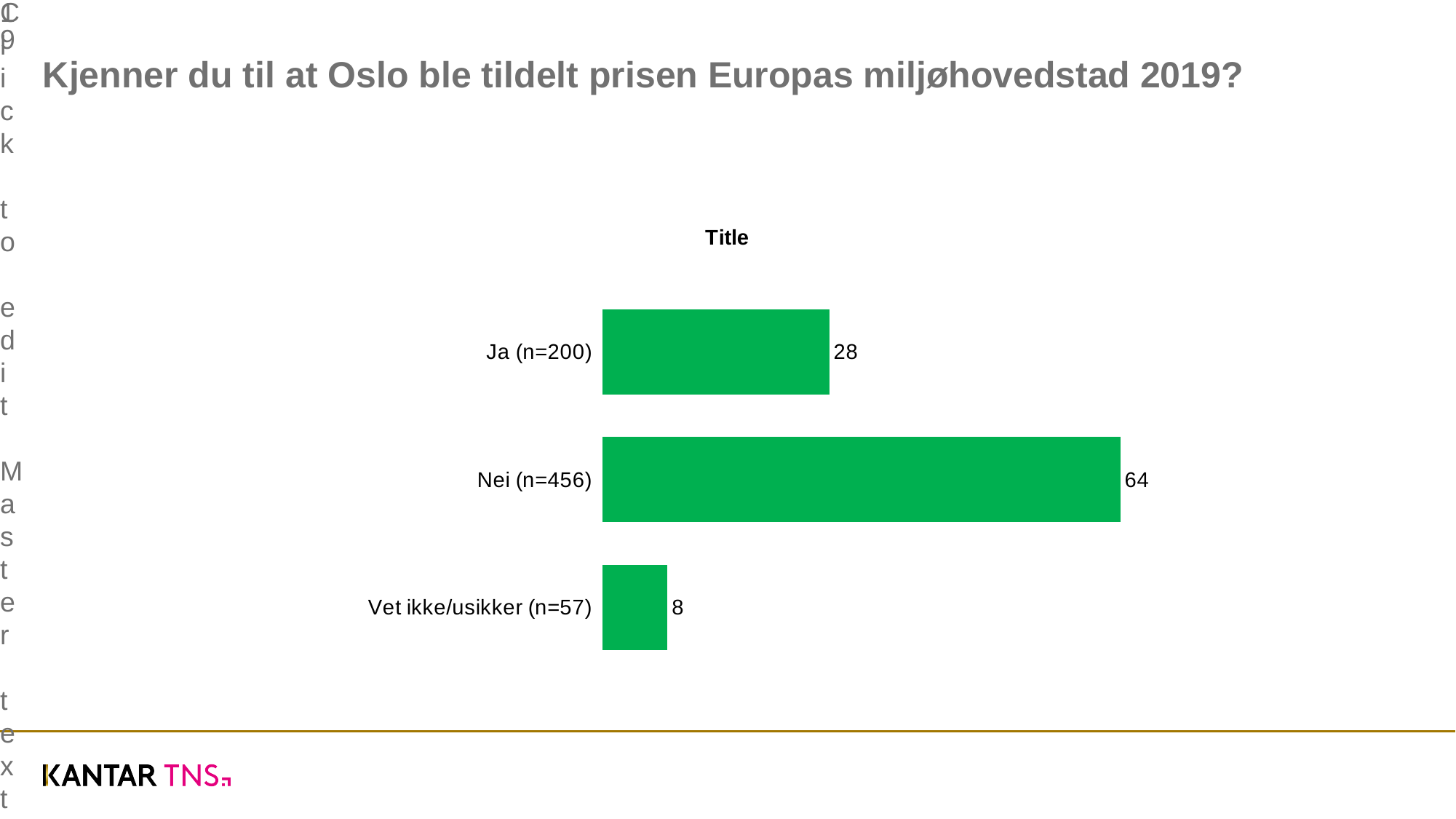
What is the value for Vet ikke/usikker (n=57)? 8 What colour are the bars in the chart? Green Which category has the highest value? Nei (n=456) How many categories are shown in the chart? 3 What kind of chart is shown on the slide? Bar chart What is the value for Ja (n=200)? 28 What is the difference between the values for Ja (n=200) and Vet ikke/usikker (n=57)? 20 Which category has the lowest value? Vet ikke/usikker (n=57) What is the title printed above the chart? Title What is the difference between the values for Nei (n=456) and Ja (n=200)? 36 What is the value for Nei (n=456)? 64 Which is larger, the value for Ja (n=200) or the value for Vet ikke/usikker (n=57)? Ja (n=200)